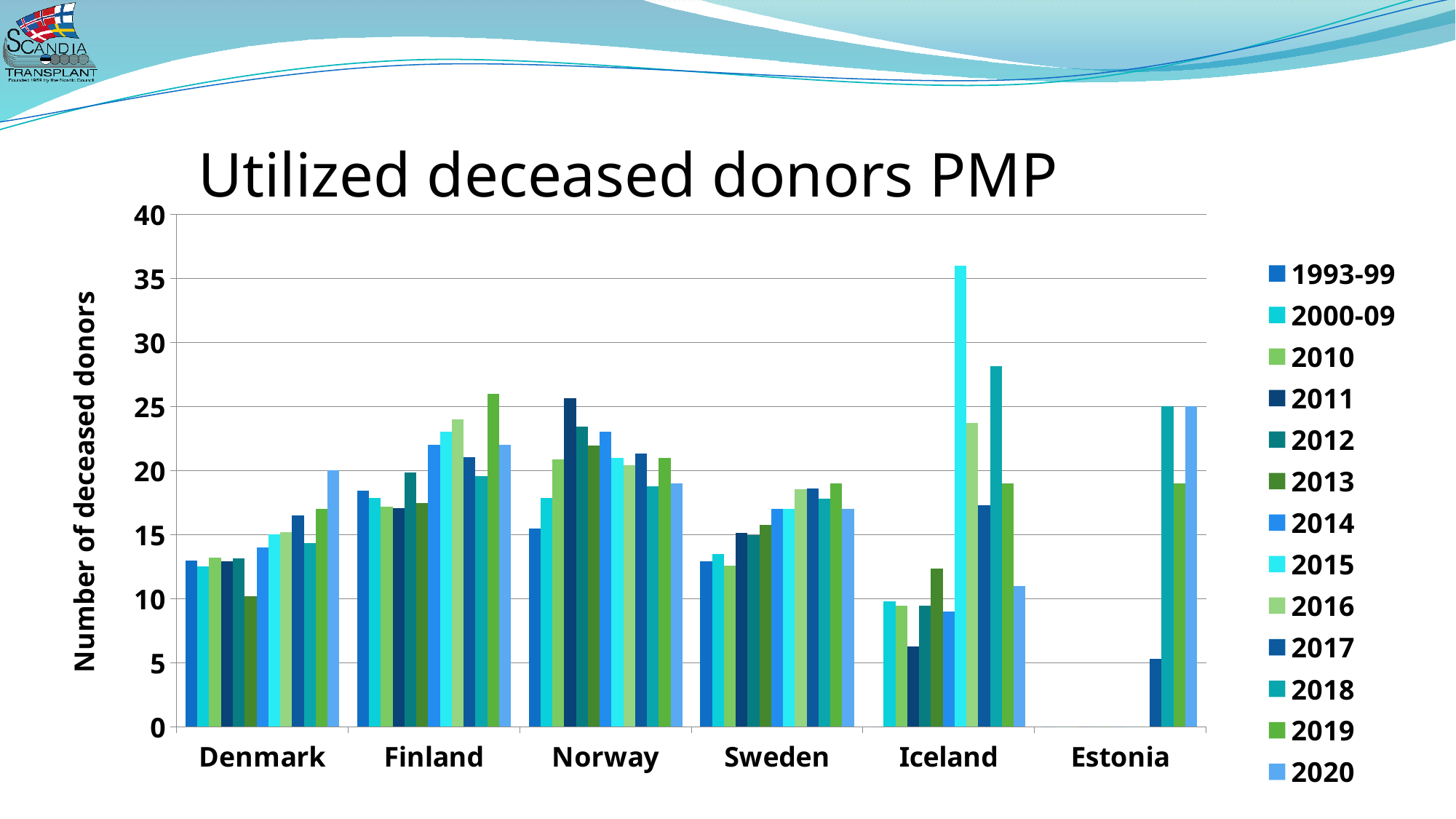
Is the value for Iceland in 2000-09 greater or less than 30? less How many series does the legend list? 13 What is the title of the y axis? Number of deceased donors What kind of chart is shown on the slide? Bar chart For Iceland, which series has the highest value? 2015 Is the value for Denmark in 2020 greater or less than 15? greater For Estonia, which series has the lowest value? 2017 Which is larger, the 2011 value for Norway or the 2011 value for Denmark? Norway Which country has the single tallest bar in the chart? Iceland How many countries are shown on the x axis of the chart? 6 For Denmark, which series has the lowest value? 2013 Is the value for Estonia in 2017 greater or less than 10? less